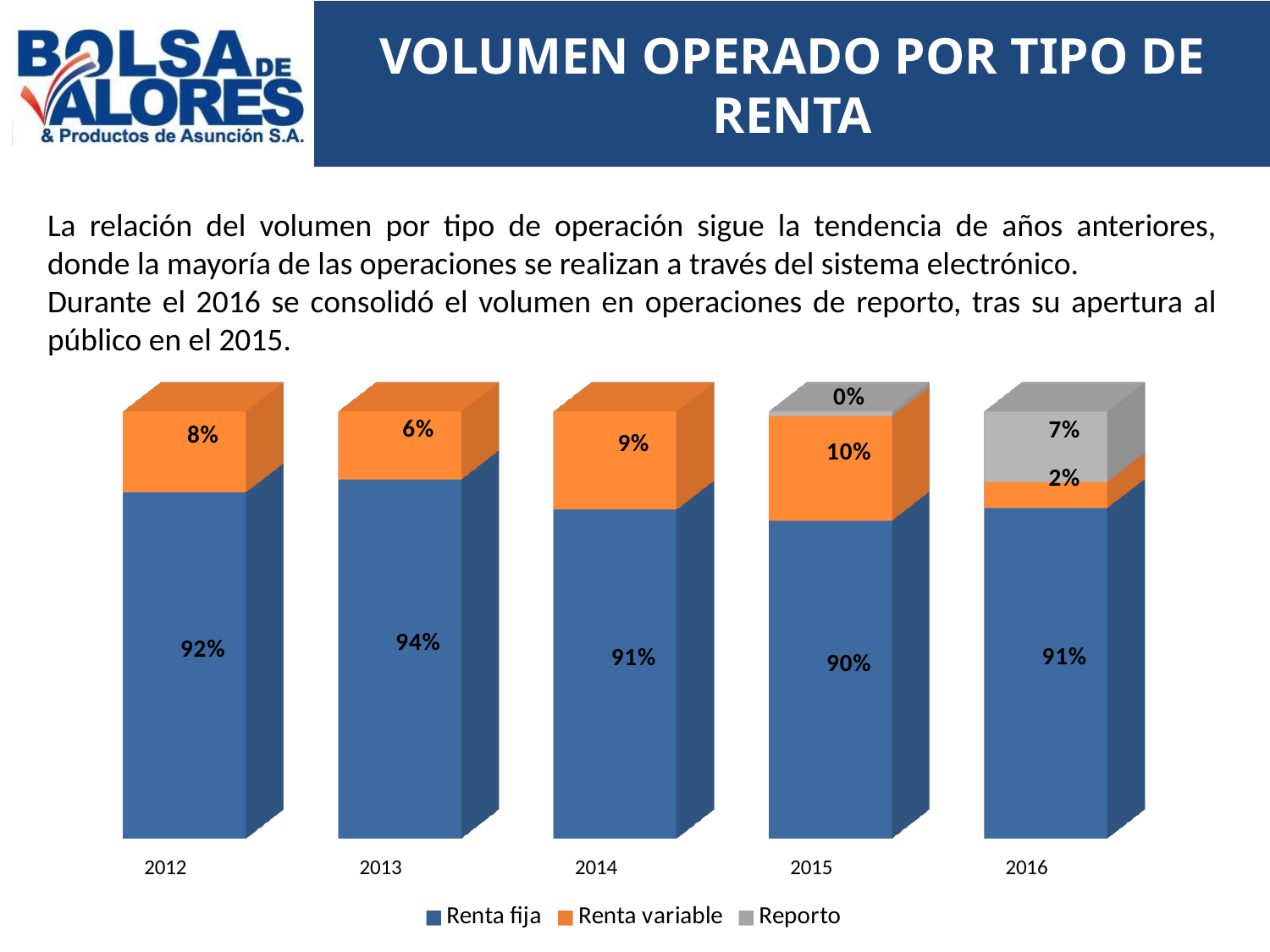
In which year is the Renta fija share highest? 2013 What is the value for Reporto in 2016? 7% What is the value for Renta variable in 2016? 2% What is the value for Renta fija in 2013? 94% How many years are shown on the x axis? 5 What is the value for Renta variable in 2015? 10% How many series does the legend list? 3 Which is larger, the Renta variable value in 2014 or in 2012? 2014 What is the difference between the Renta fija values for 2013 and 2015? 4% In which year is the Renta variable share lowest? 2016 Which series is shown in grey in the legend? Reporto What kind of chart is shown on the slide? Stacked bar chart